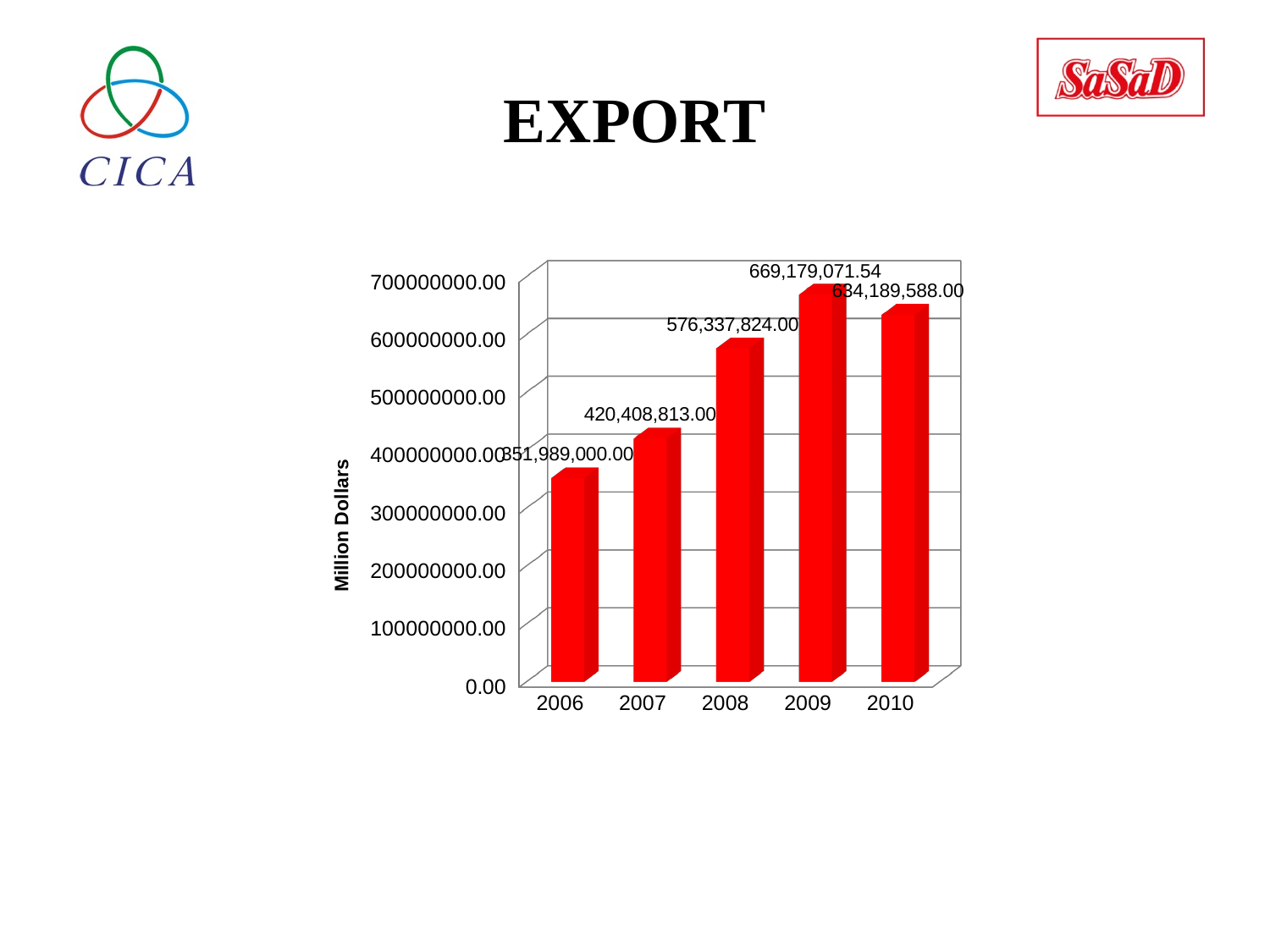
Which year has the highest export value? 2009 Which year has a larger export value, 2008 or 2010? 2010 Which year has the lowest export value? 2006 Is the export value for 2007 greater or less than 500000000.00? less What is the export value for 2007? 420,408,813.00 What is the difference between the export values for 2008 and 2007? 155,929,011.00 How many years are shown on the x axis of the chart? 5 What is the export value for 2008? 576,337,824.00 What kind of chart is shown on the slide? bar chart What is the difference between the export values for 2009 and 2010? 34,989,483.54 What is the export value for 2010? 634,189,588.00 What is the export value for 2009? 669,179,071.54